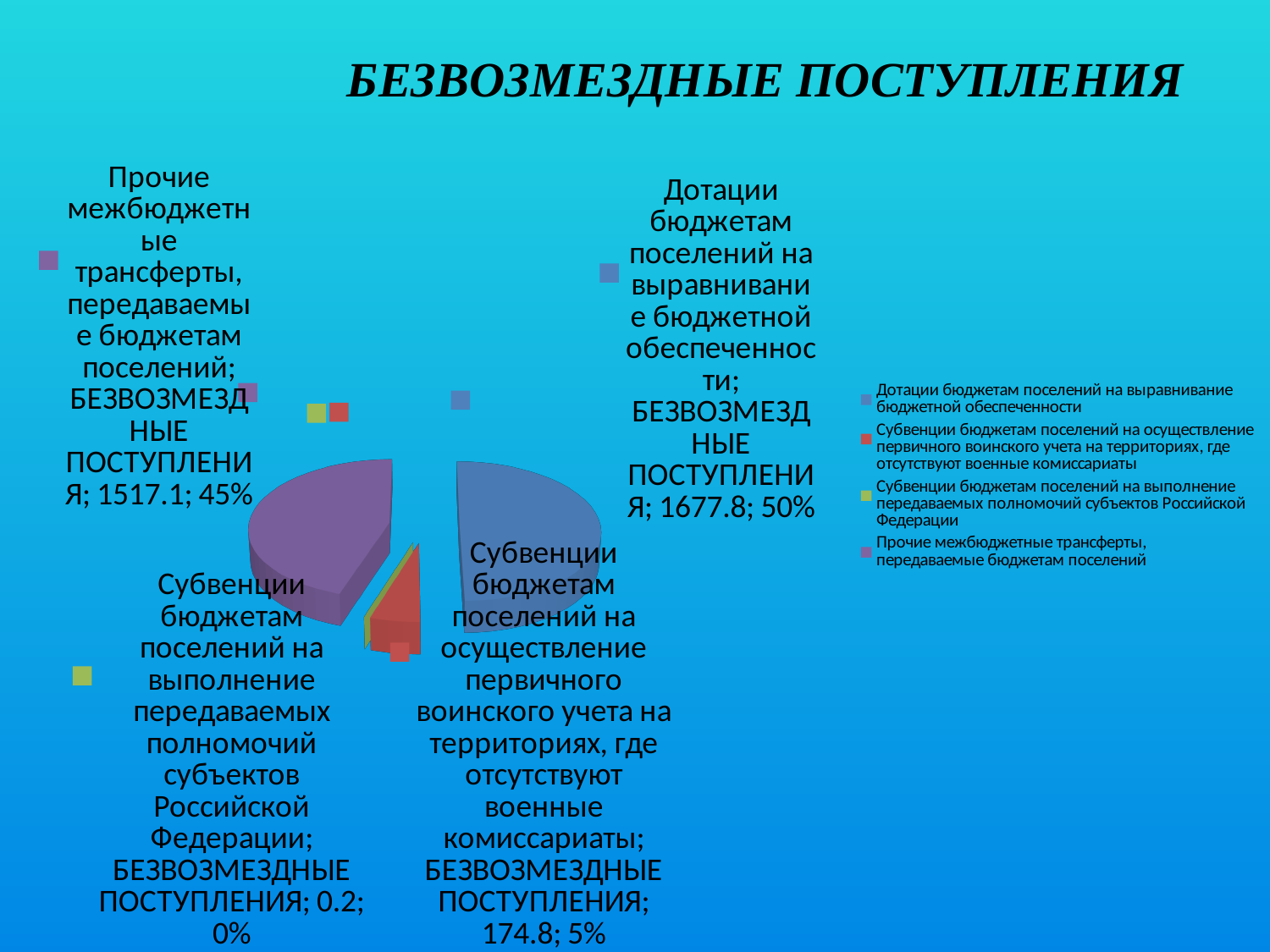
Which is larger: the value for "Субвенции бюджетам поселений на осуществление первичного воинского учета..." or for "Субвенции бюджетам поселений на выполнение передаваемых полномочий..."? Субвенции бюджетам поселений на осуществление первичного воинского учета на территориях, где отсутствуют военные комиссариаты What value is shown for the slice "Прочие межбюджетные трансферты, передаваемые бюджетам поселений"? 1517.1 What percentage share of the pie does "Дотации бюджетам поселений на выравнивание бюджетной обеспеченности" have? 50% What value is shown for the slice "Субвенции бюджетам поселений на осуществление первичного воинского учета на территориях, где отсутствуют военные комиссариаты"? 174.8 What type of chart is shown on the slide? Pie chart Which category has the largest slice of the pie? Дотации бюджетам поселений на выравнивание бюджетной обеспеченности Which category has the smallest slice of the pie? Субвенции бюджетам поселений на выполнение передаваемых полномочий субъектов Российской Федерации How many categories does the pie chart have? 4 What value is shown for the slice "Субвенции бюджетам поселений на выполнение передаваемых полномочий субъектов Российской Федерации"? 0.2 What percentage share of the pie does "Прочие межбюджетные трансферты, передаваемые бюджетам поселений" have? 45% What is the difference between the values for "Дотации бюджетам поселений на выравнивание бюджетной обеспеченности" and "Прочие межбюджетные трансферты, передаваемые бюджетам поселений"? 160.7 What value is shown for the slice "Дотации бюджетам поселений на выравнивание бюджетной обеспеченности"? 1677.8